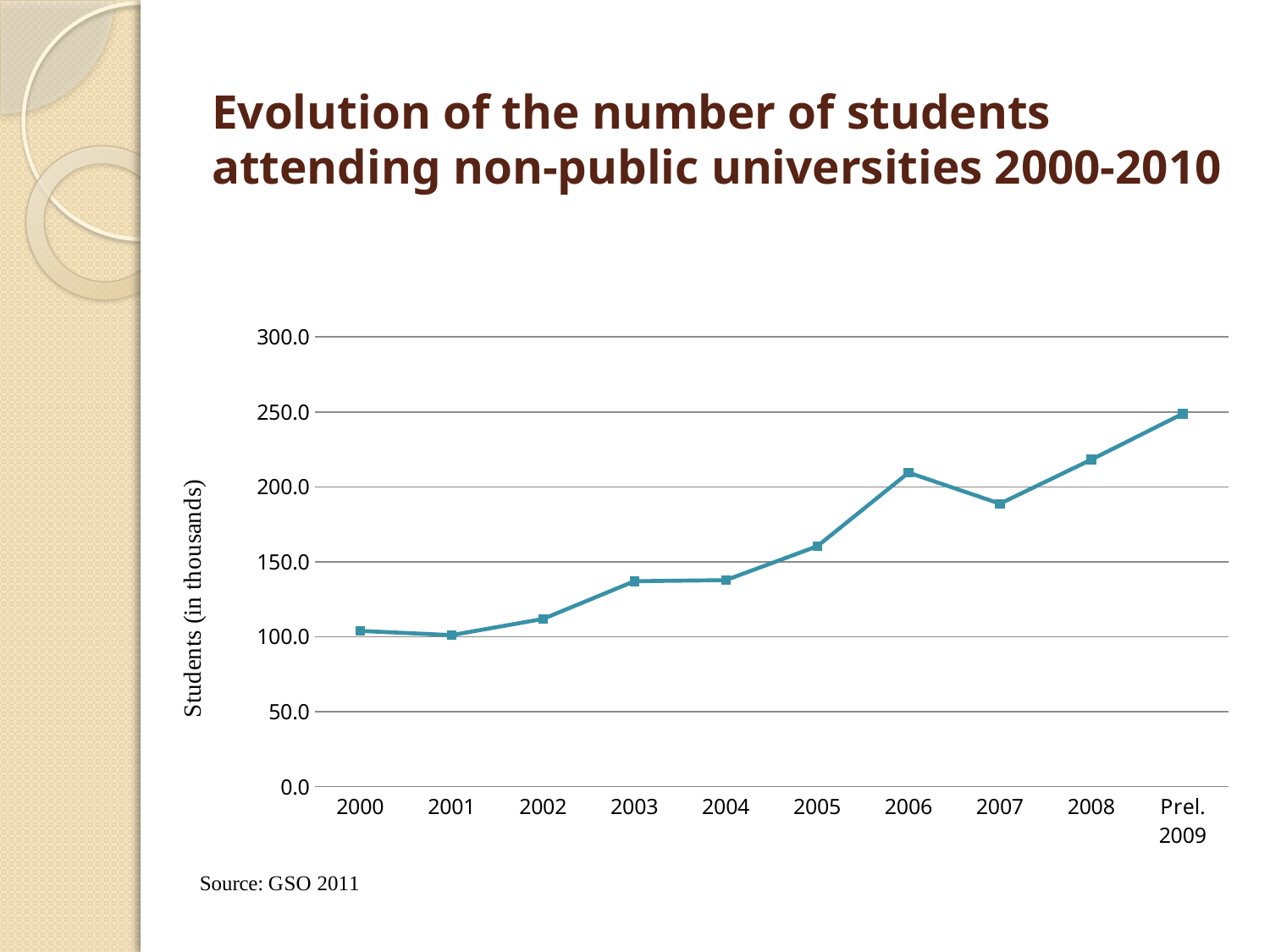
What kind of chart is shown on the slide? line chart Which year has the larger value, 2006 or 2007? 2006 How many data points are plotted on the chart? 10 What is the label on the vertical axis of the chart? Students (in thousands) Is the value for 2007 greater or less than 200.0? less What source is cited below the chart? GSO 2011 Is the value for 2003 greater or less than 150.0? less Which year has the highest number of students attending non-public universities? Prel. 2009 Is the value for 2006 greater or less than 200.0? greater Overall, do the values rise or fall from 2000 to Prel. 2009? rise